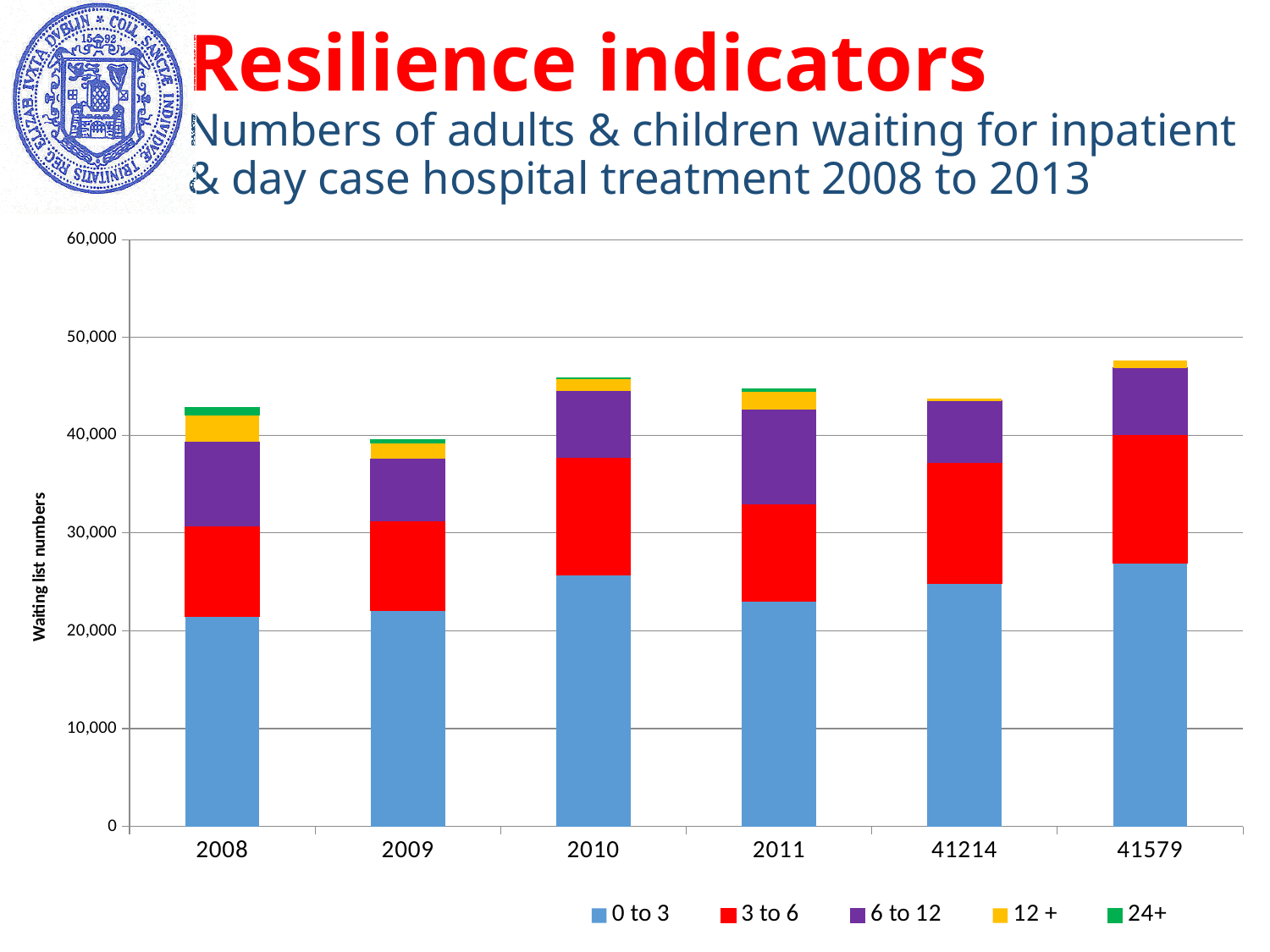
Is the '0 to 3' value for 41579 greater or less than 30,000? less How many categories are shown along the x axis? 6 What is the title of the vertical axis? Waiting list numbers Which has the larger total stacked bar, 2008 or 2009? 2008 Which category has the lowest total stacked bar? 2009 Which category has the highest total stacked bar? 41579 Is the total stacked bar for 2008 greater or less than 40,000? greater What kind of chart is shown on the slide? stacked bar chart Which series is shown in red in the legend? 3 to 6 Is the total stacked bar for 41579 greater or less than 50,000? less How many series does the legend list? 5